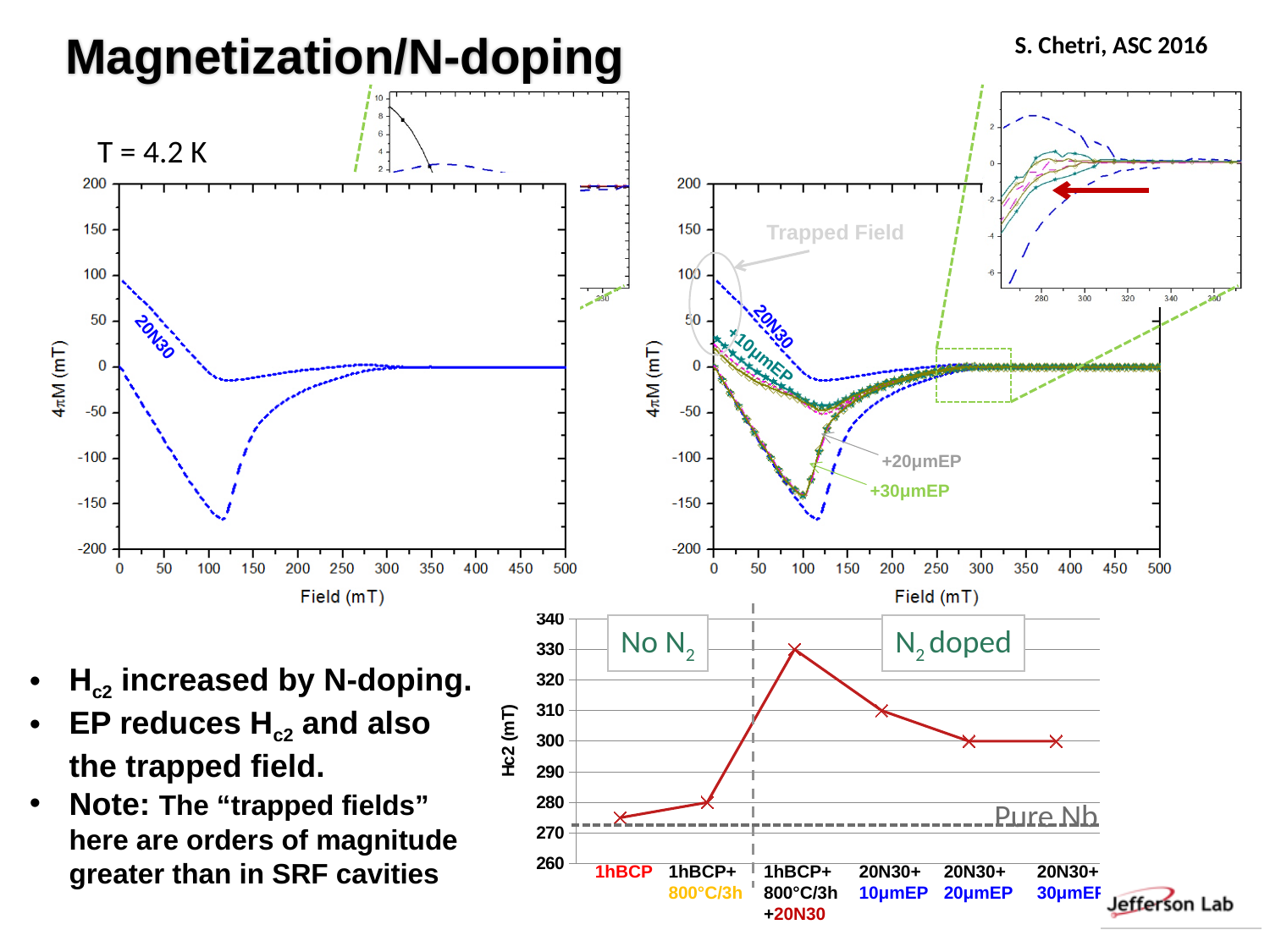
In the bottom Hc2 chart, what is the Hc2 value for 20N30+10µmEP? 310 How many samples are plotted along the x axis of the bottom Hc2 chart? 6 In the bottom Hc2 chart, what is the difference in Hc2 between 1hBCP+800°C/3h+20N30 and 20N30+10µmEP? 20 In the bottom Hc2 chart, do the Hc2 values rise or fall from 1hBCP+800°C/3h+20N30 to 20N30+30µmEP? fall In the bottom Hc2 chart, which sample has the highest Hc2? 1hBCP+800°C/3h+20N30 In the bottom Hc2 chart, which has a larger Hc2: 1hBCP+800°C/3h or 20N30+30µmEP? 20N30+30µmEP In the bottom Hc2 chart, is the Hc2 value for 1hBCP greater or less than 280? less What kind of chart is the bottom Hc2 chart? line chart In the bottom Hc2 chart, what is the Hc2 value for 1hBCP+800°C/3h+20N30? 330 What is the y-axis label of the two magnetization charts at the top of the slide? 4πM (mT) In the bottom Hc2 chart, which sample has the lowest Hc2? 1hBCP In the bottom Hc2 chart, what is the Hc2 value for 20N30+20µmEP? 300